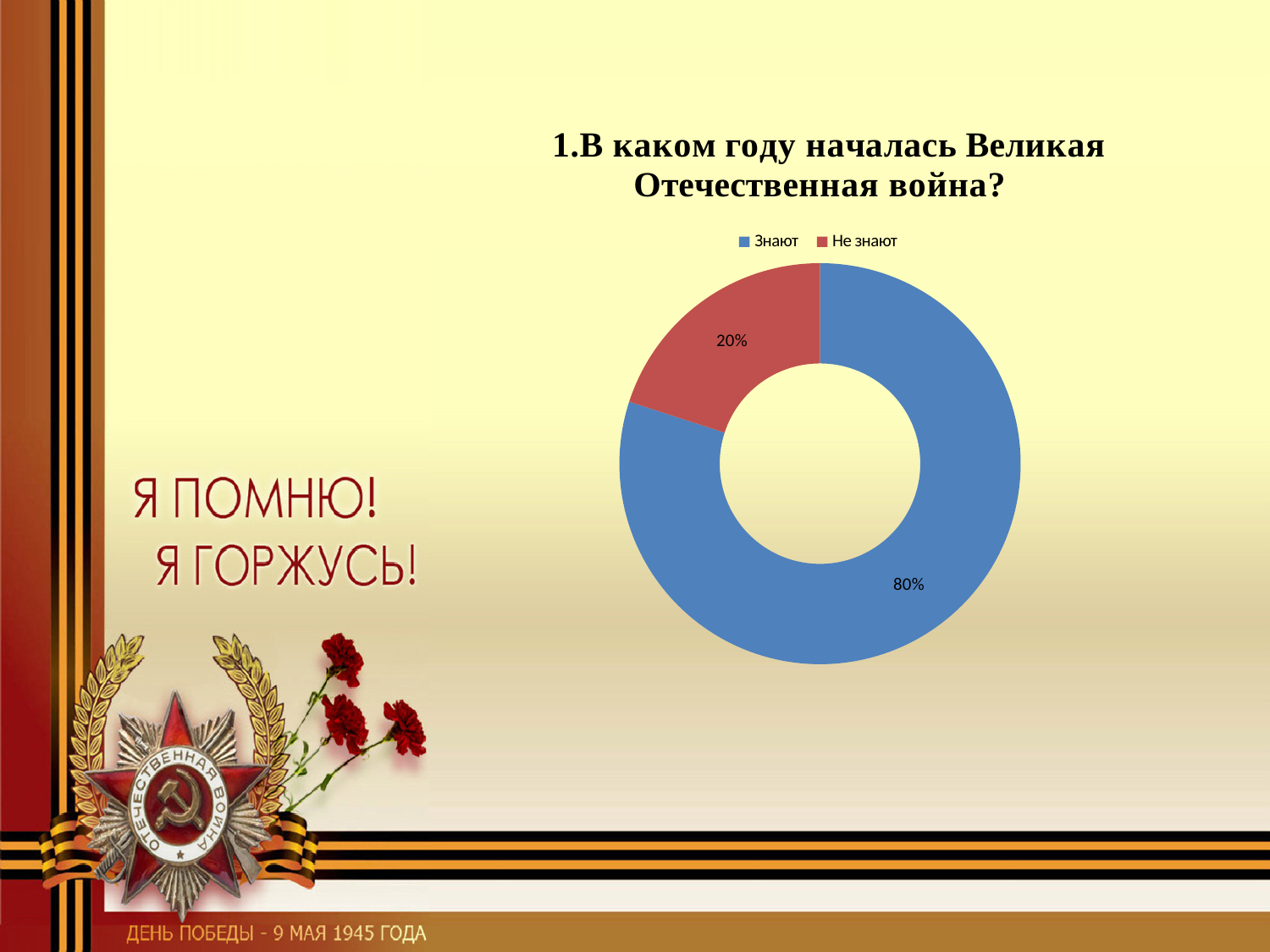
What kind of chart is shown on the slide? Doughnut (pie) chart What share of the chart does the "Не знают" slice represent? 20% What colour is the "Не знают" slice? Red Which is larger, the "Знают" slice or the "Не знают" slice? Знают Which category has the smallest slice? Не знают What is the difference between the "Знают" and "Не знают" shares? 60% Which category has the largest slice? Знают How many categories does the chart show? 2 What share of the chart does the "Знают" slice represent? 80% How many entries does the legend list? 2 What is the title of the chart? 1.В каком году началась Великая Отечественная война?